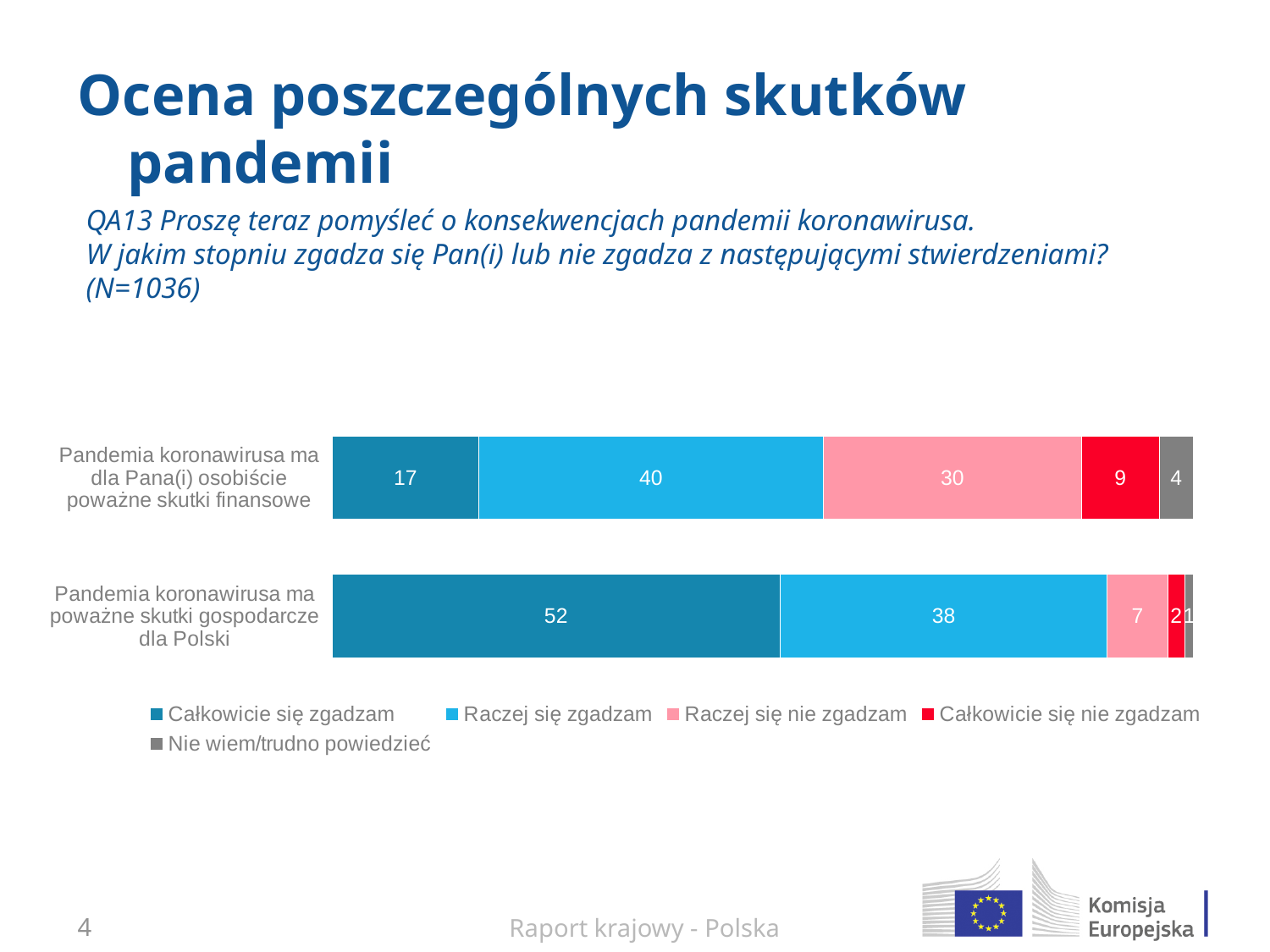
What is the value for "Całkowicie się zgadzam" for the statement "Pandemia koronawirusa ma poważne skutki gospodarcze dla Polski"? 52 What is the value for "Nie wiem/trudno powiedzieć" for the statement "Pandemia koronawirusa ma dla Pana(i) osobiście poważne skutki finansowe"? 4 How many statements (categories) are plotted in the chart? 2 Which statement has the higher value for "Całkowicie się zgadzam"? Pandemia koronawirusa ma poważne skutki gospodarcze dla Polski What is the total of the stacked bar for "Pandemia koronawirusa ma poważne skutki gospodarcze dla Polski"? 100 How many series does the legend list? 5 Which series in the legend is shown in red? Całkowicie się nie zgadzam What kind of chart is shown on the slide? stacked bar chart What is the value for "Raczej się zgadzam" for the statement "Pandemia koronawirusa ma dla Pana(i) osobiście poważne skutki finansowe"? 40 What is the difference between the "Całkowicie się zgadzam" values for the two statements? 35 What is the value for "Całkowicie się nie zgadzam" for the statement "Pandemia koronawirusa ma poważne skutki gospodarcze dla Polski"? 2 What is the value for "Raczej się nie zgadzam" for the statement "Pandemia koronawirusa ma dla Pana(i) osobiście poważne skutki finansowe"? 30